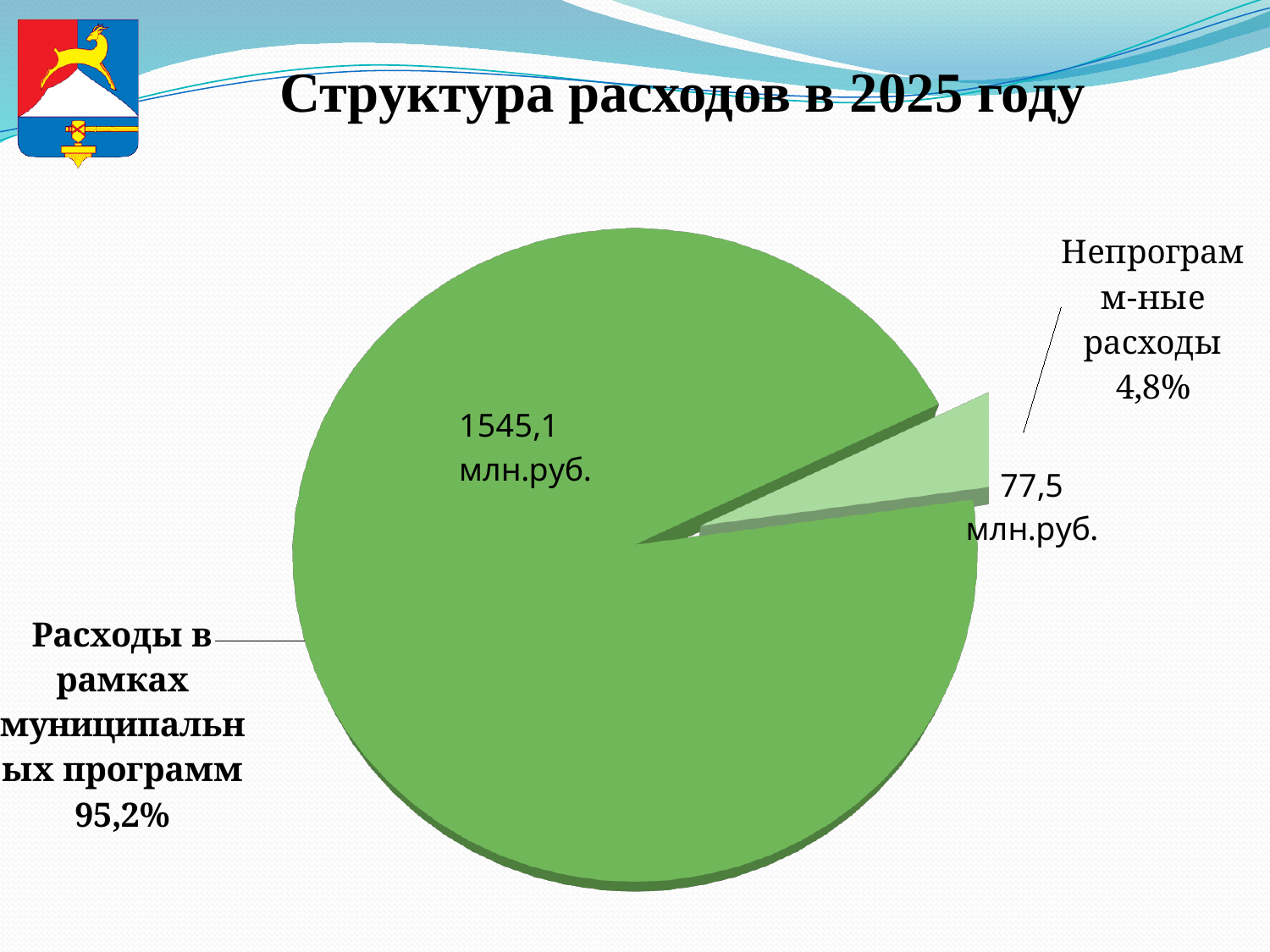
Which is larger: Расходы в рамках муниципальных программ or Непрограммные расходы? Расходы в рамках муниципальных программ Which slice is the smallest? Непрограммные расходы What is the total of the two slices in млн.руб.? 1622,6 млн.руб. What kind of chart is shown on the slide? pie chart What is the value for Расходы в рамках муниципальных программ? 1545,1 млн.руб. What is the difference in млн.руб. between Расходы в рамках муниципальных программ and Непрограммные расходы? 1467,6 млн.руб. What share of the pie is Непрограммные расходы? 4,8% What share of the pie is Расходы в рамках муниципальных программ? 95,2% How many slices does the pie chart have? 2 What is the value for Непрограммные расходы? 77,5 млн.руб. What is the title of the chart? Структура расходов в 2025 году Which slice is the largest? Расходы в рамках муниципальных программ